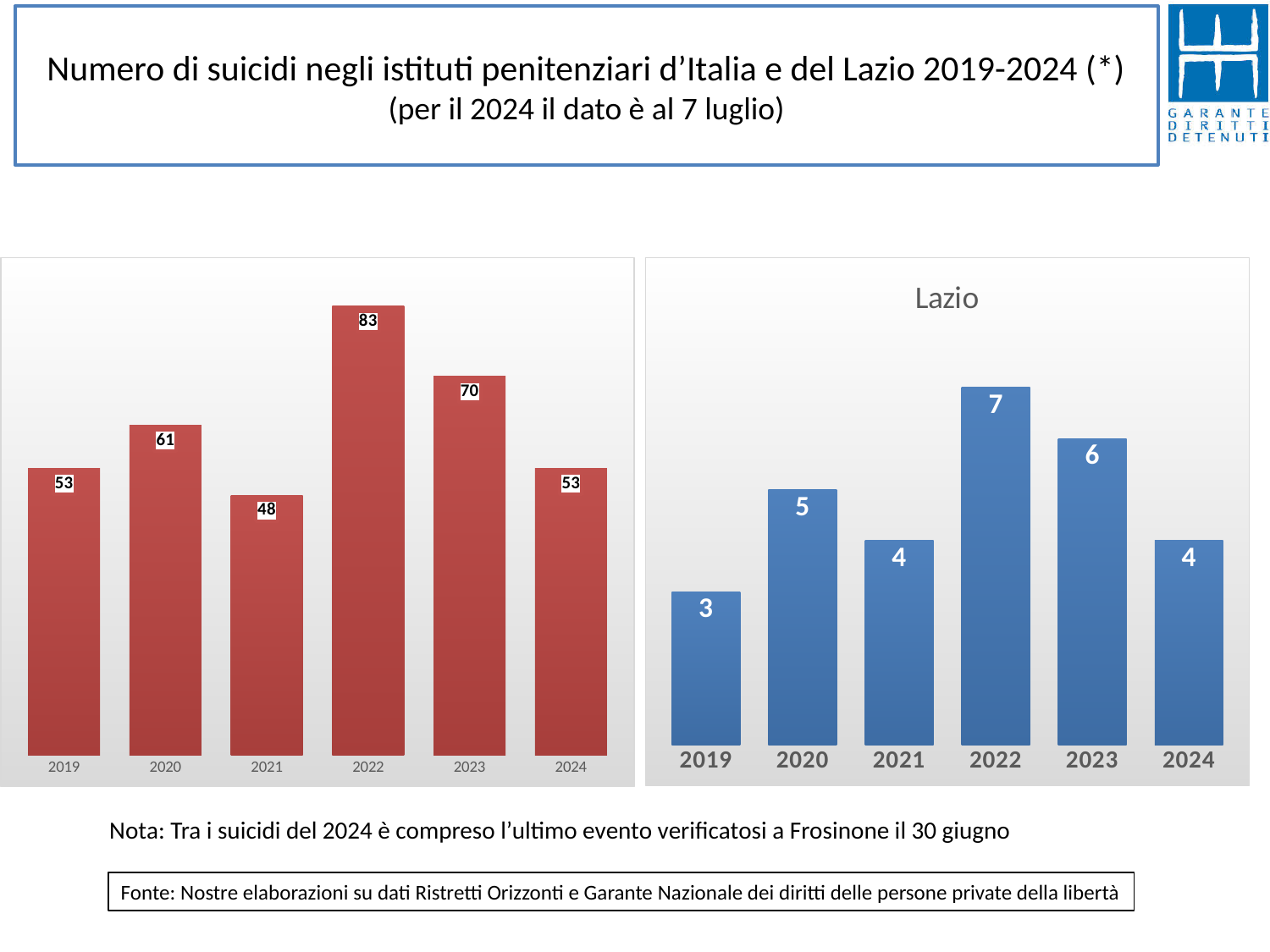
In the left chart, which year has the lowest value? 2021 How many years are shown on the x axis of the Lazio chart? 6 In the left chart, which is larger, the value for 2020 or the value for 2021? 2020 What kind of chart is the left chart? bar chart In the left chart, what is the value for 2022? 83 In the Lazio chart, what is the value for 2020? 5 In the Lazio chart, which is larger, the value for 2023 or the value for 2024? 2023 In the Lazio chart, which year has the highest value? 2022 What is the title of the right chart? Lazio In the Lazio chart, what is the difference between the values for 2022 and 2019? 4 In the left chart, what is the difference between the values for 2022 and 2023? 13 In the left chart, do the values rise or fall from 2022 to 2024? fall